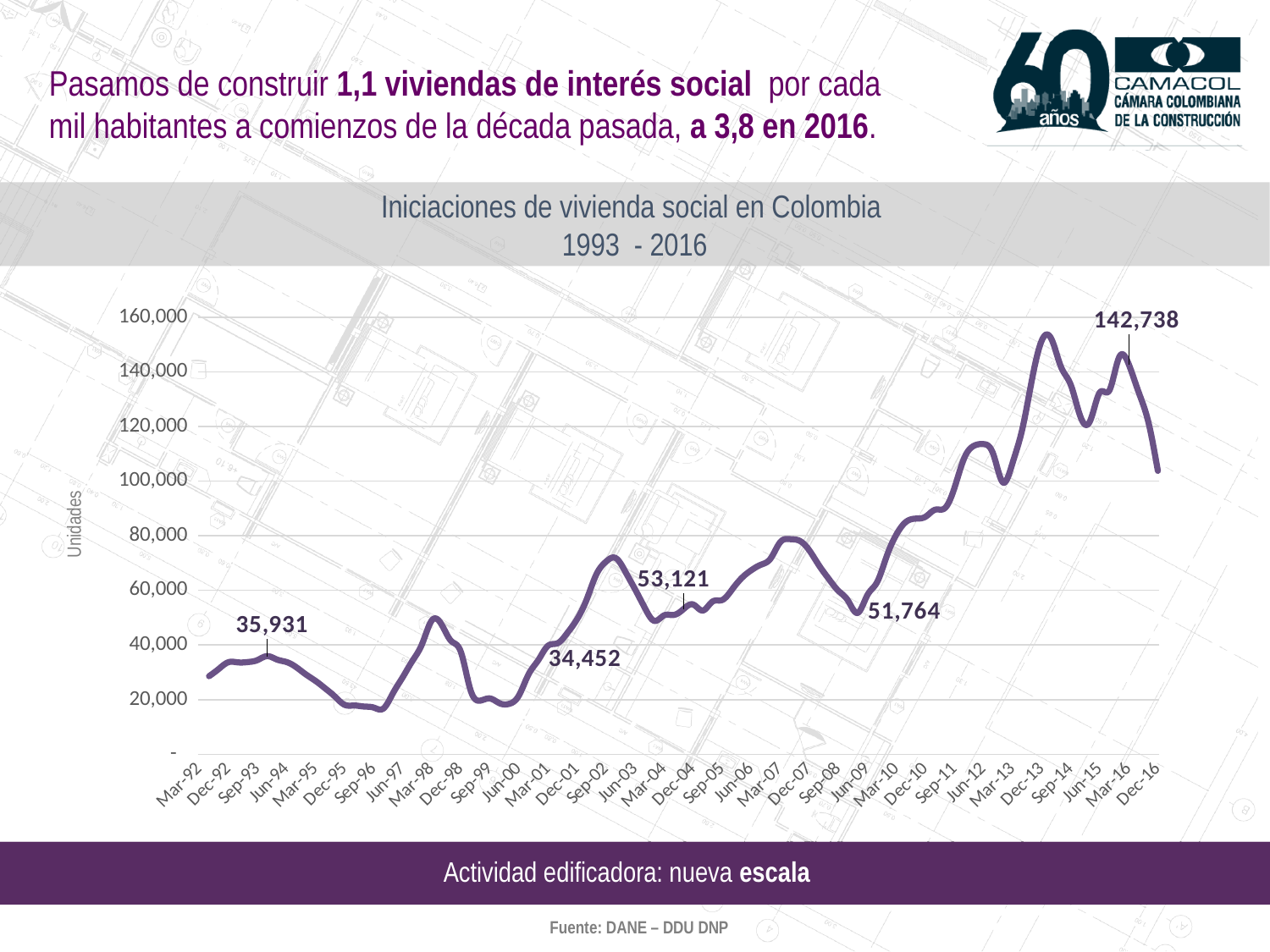
What value is labeled on the line near Sep-93? 35,931 What is the difference between the labeled values 53,121 and 51,764? 1,357 Overall, do the values rise or fall from Mar-92 to Dec-16? rise What is the lowest value labeled on the chart? 34,452 What is the highest value labeled on the chart? 142,738 What value is labeled on the line near Jun-09? 51,764 What is the label on the vertical axis of the chart? Unidades What kind of chart is shown on the slide? line chart Which labeled value is larger, 35,931 or 34,452? 35,931 What value is labeled on the line near Mar-16? 142,738 Is the value for Dec-16 greater or less than 120,000? less What is the title of the chart? Iniciaciones de vivienda social en Colombia 1993 - 2016